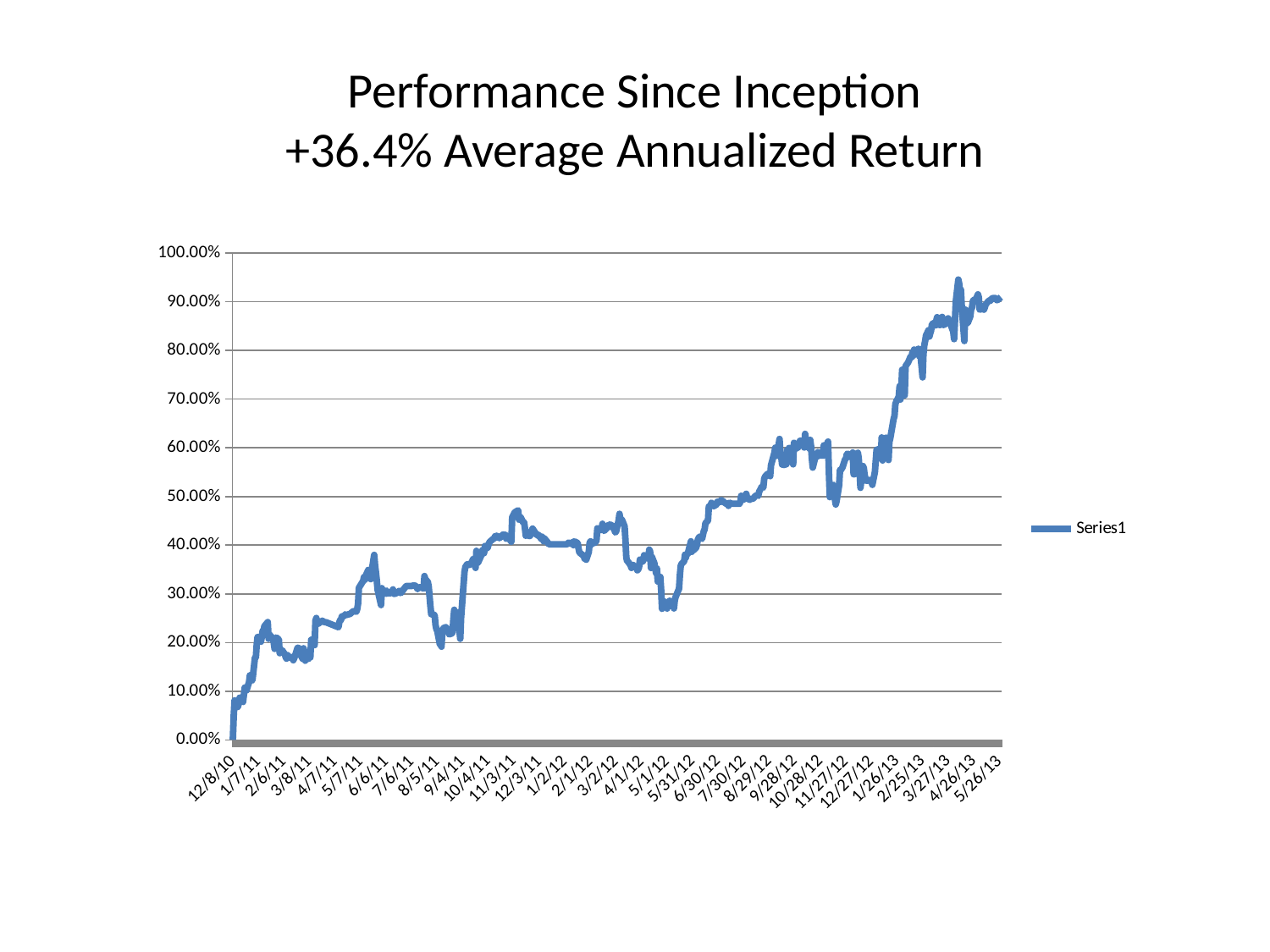
Is the value at 5/1/12 greater or less than 40.00%? less What is the title of the chart? Performance Since Inception +36.4% Average Annualized Return Is the value at 9/28/12 greater or less than 50.00%? greater Is the value at 8/5/11 greater or less than 40.00%? less How many series does the legend list? 1 Overall, does the line rise or fall from 12/8/10 to 5/26/13? rise At which x-axis date does the line reach its lowest value? 12/8/10 What is the name of the series shown in the legend? Series1 What kind of chart is shown on the slide? line chart